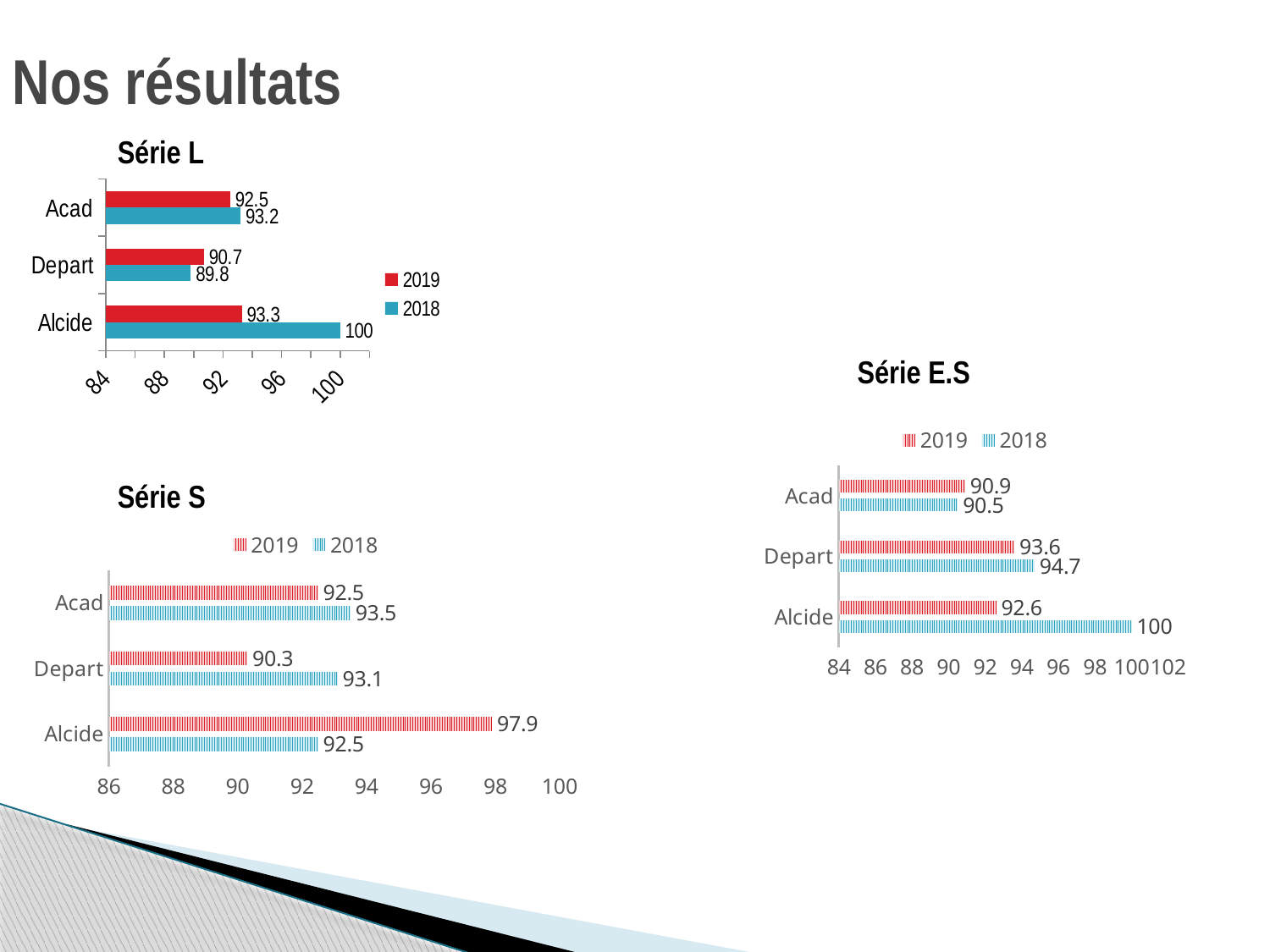
In the 'Série S' chart, what is the 2019 value for Alcide? 97.9 What kind of chart is the 'Série L' chart? Bar chart How many series does the legend of the 'Série E.S' chart list? 2 In the 'Série E.S' chart, what is the difference between the 2018 and 2019 values for Alcide? 7.4 In the 'Série L' chart, what is the 2019 value for Acad? 92.5 In the 'Série E.S' chart, what is the 2018 value for Depart? 94.7 In the 'Série L' chart, which category has the lowest 2018 value? Depart In the 'Série S' chart, what is the difference between the 2018 and 2019 values for Depart? 2.8 In the 'Série L' chart, what is the 2018 value for Alcide? 100 In the 'Série S' chart, which category has the highest 2019 value? Alcide In the 'Série E.S' chart, which is larger for Acad, the 2019 value or the 2018 value? 2019 How many categories are shown in the 'Série S' chart? 3